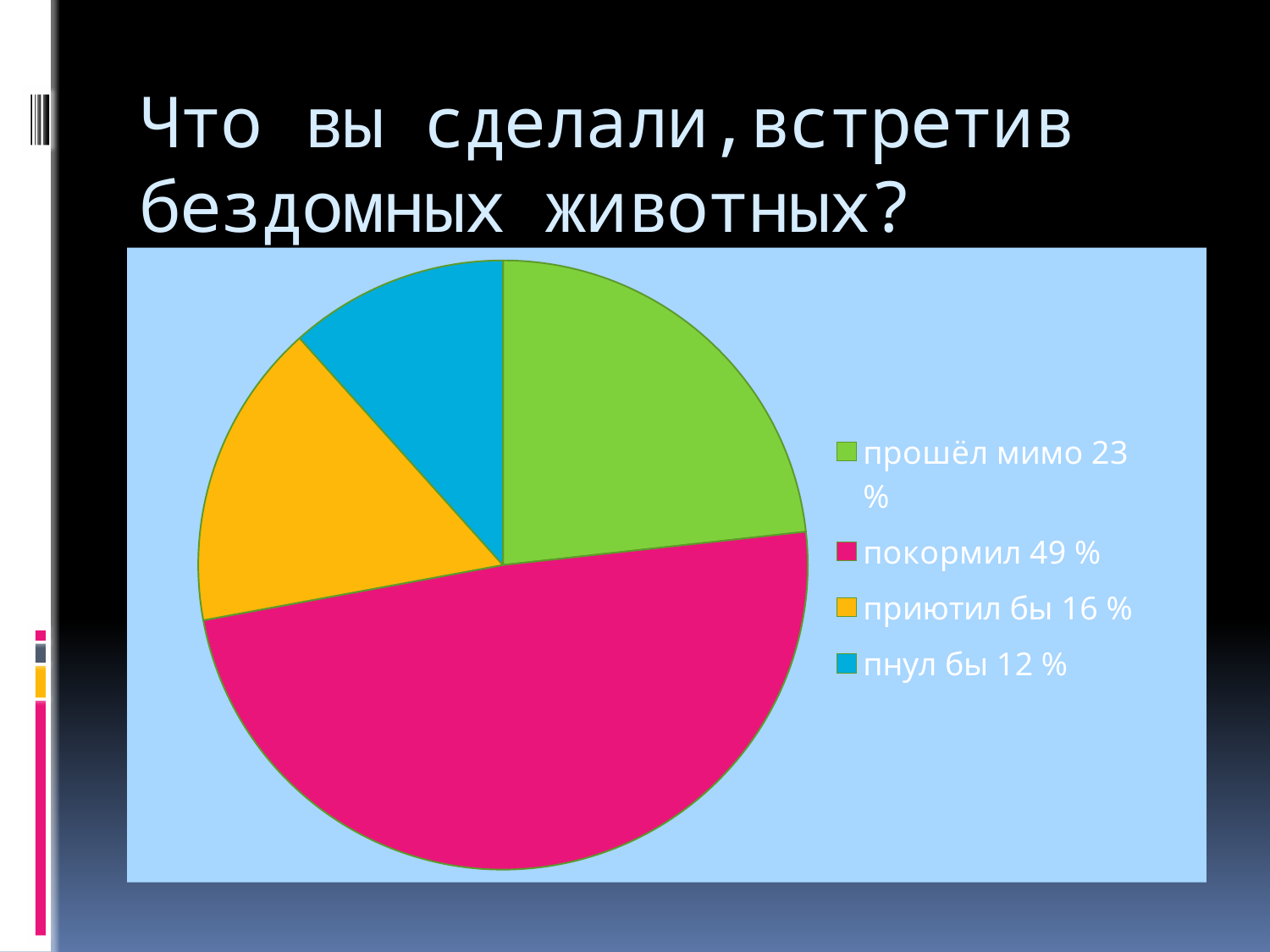
What percentage is shown for "приютил бы"? 16 % What kind of chart is shown on the slide? pie chart What percentage is shown for "прошёл мимо"? 23 % Which category has the largest share of the pie? покормил What is the difference in percentage points between "покормил" and "прошёл мимо"? 26 What percentage is shown for "покормил"? 49 % Which category has the smallest share of the pie? пнул бы Which is larger, the share for "приютил бы" or the share for "пнул бы"? приютил бы How many slices does the pie chart have? 4 What percentage is shown for "пнул бы"? 12 % What colour is the slice for "покормил"? pink (magenta) What is the title of the slide above the chart? Что вы сделали, встретив бездомных животных?